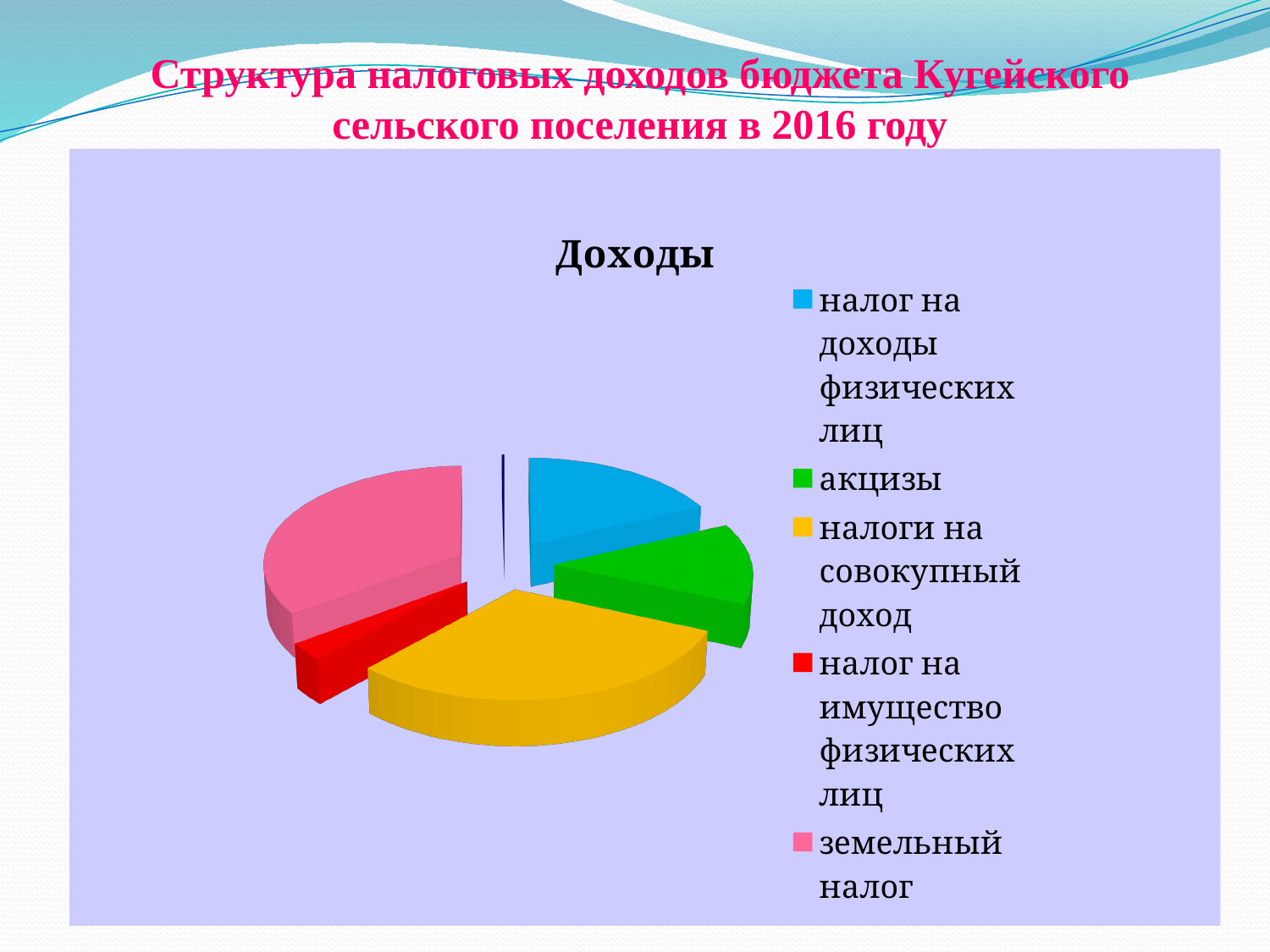
Which category has the largest slice of the pie? земельный налог Which category is shown in yellow in the pie chart? налоги на совокупный доход What is the title of the chart? Доходы Which slice is larger: земельный налог or налоги на совокупный доход? земельный налог Which slice is larger: земельный налог or налог на доходы физических лиц? земельный налог Which slice is larger: налоги на совокупный доход or акцизы? налоги на совокупный доход What kind of chart is shown on the slide? Pie chart